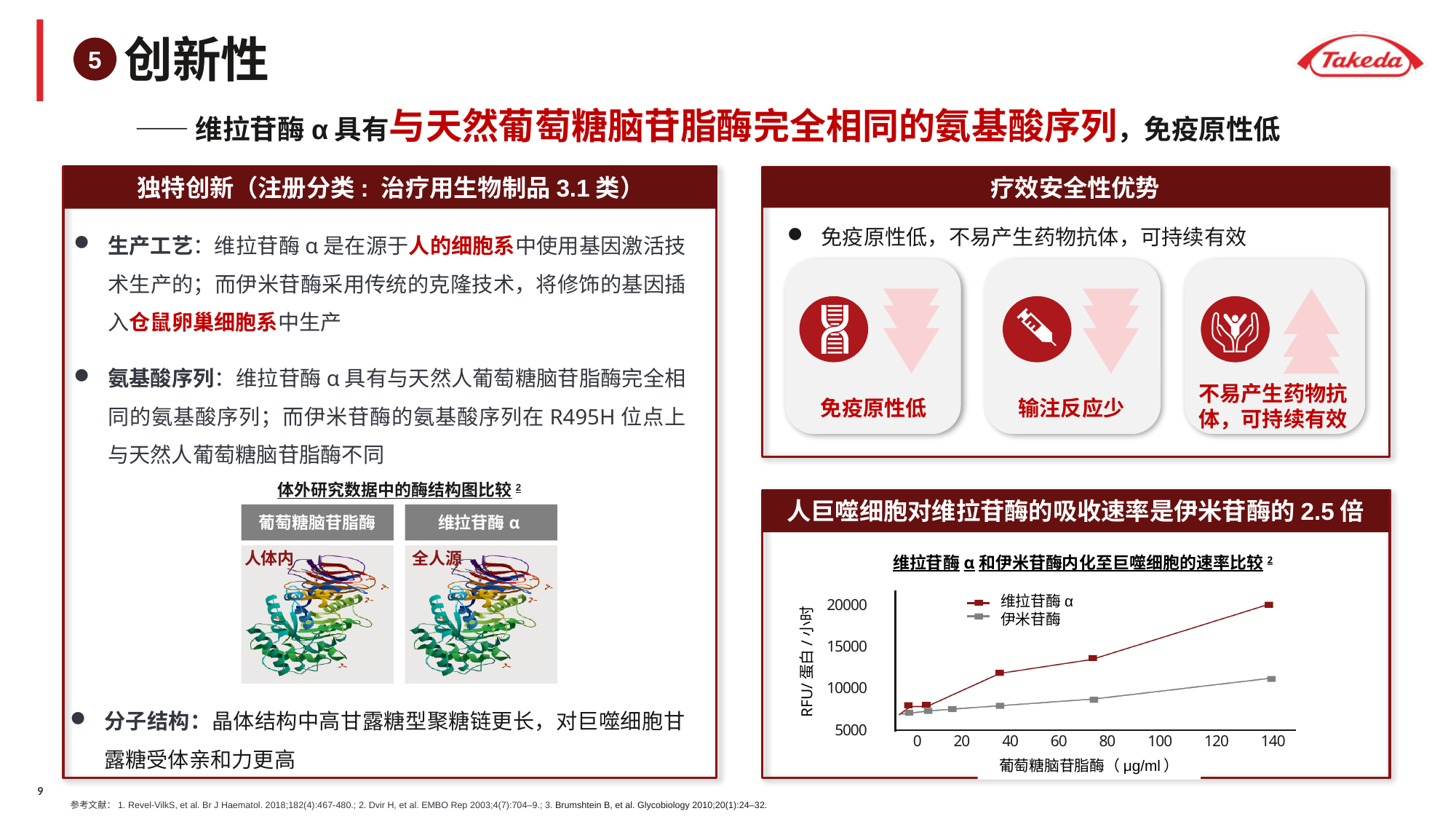
In the line chart, at 140 μg/ml, which series has the higher value, 维拉苷酶 α or 伊米苷酶? 维拉苷酶 α In the line chart, does the value for 维拉苷酶 α rise or fall as the x-axis value increases? rise In the line chart, which series reaches the highest value on the chart? 维拉苷酶 α How many series does the legend of the line chart list? 2 In the line chart, is the value for 伊米苷酶 at 140 μg/ml greater or less than 15000? less In the line chart, is the value for 伊米苷酶 at 140 μg/ml greater or less than 10000? greater Which two series are listed in the legend of the line chart? 维拉苷酶 α and 伊米苷酶 In the line chart, does the value for 伊米苷酶 rise or fall as the x-axis value increases? rise What is the x-axis label of the line chart? 葡萄糖脑苷脂酶（μg/ml） In the line chart, is the value for 伊米苷酶 at 80 μg/ml greater or less than 10000? less What kind of chart is shown under the heading 人巨噬细胞对维拉苷酶的吸收速率是伊米苷酶的 2.5 倍? line chart